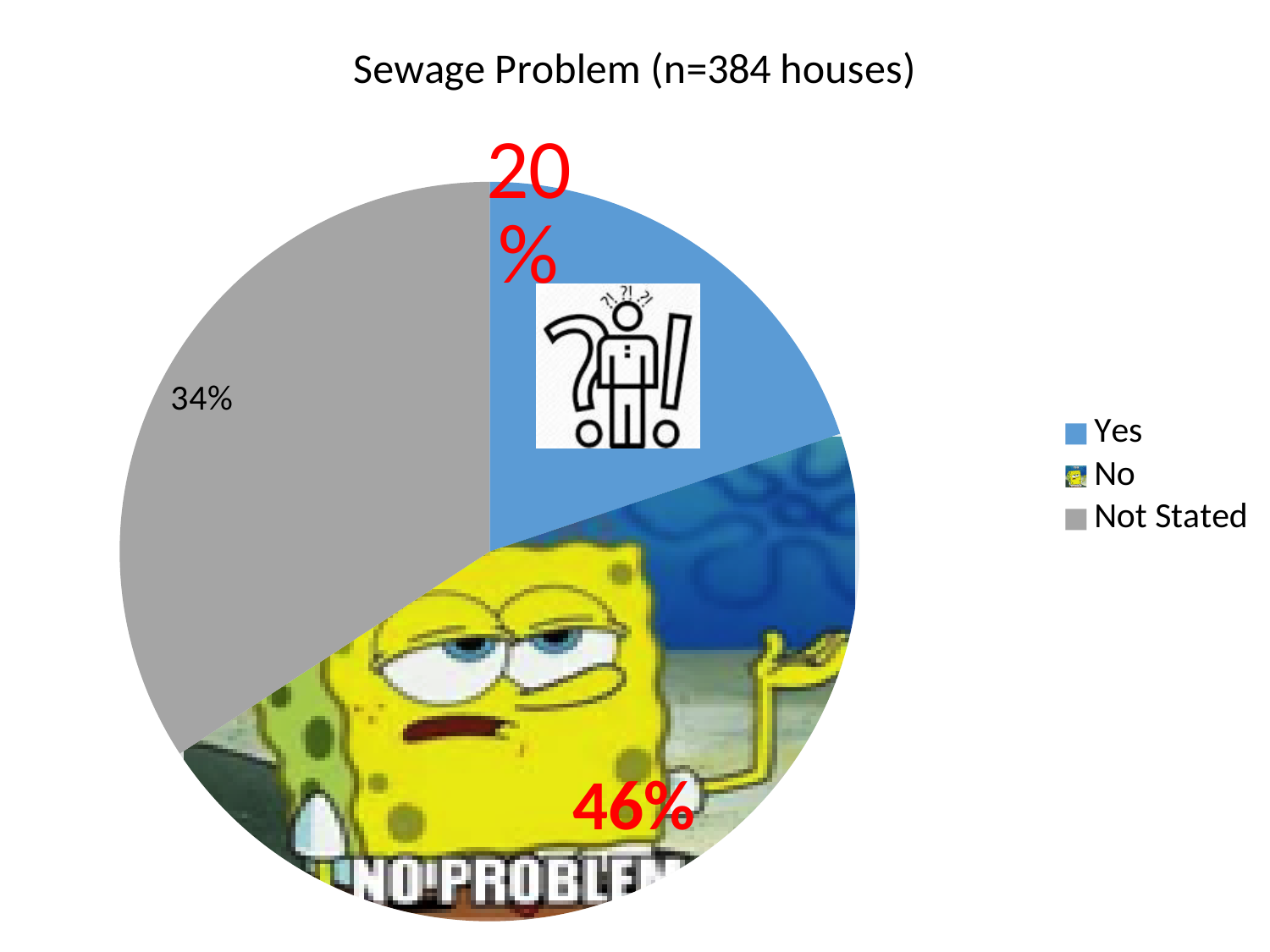
What is the difference in percentage points between the "Not Stated" and "Yes" slices? 14 Which category has the smallest share of the pie? Yes Which category has the largest share of the pie? No How many houses were surveyed according to the chart title? 384 What percentage of houses answered "No" to having a sewage problem? 46% What percentage of houses answered "Yes" to having a sewage problem? 20% What kind of chart is shown on the slide? pie chart What is the title of the chart? Sewage Problem (n=384 houses) What percentage of houses are in the "Not Stated" category? 34% Which is larger, the "Not Stated" slice or the "Yes" slice? Not Stated What is the difference in percentage points between the "No" and "Yes" slices? 26 How many categories does the pie chart have? 3